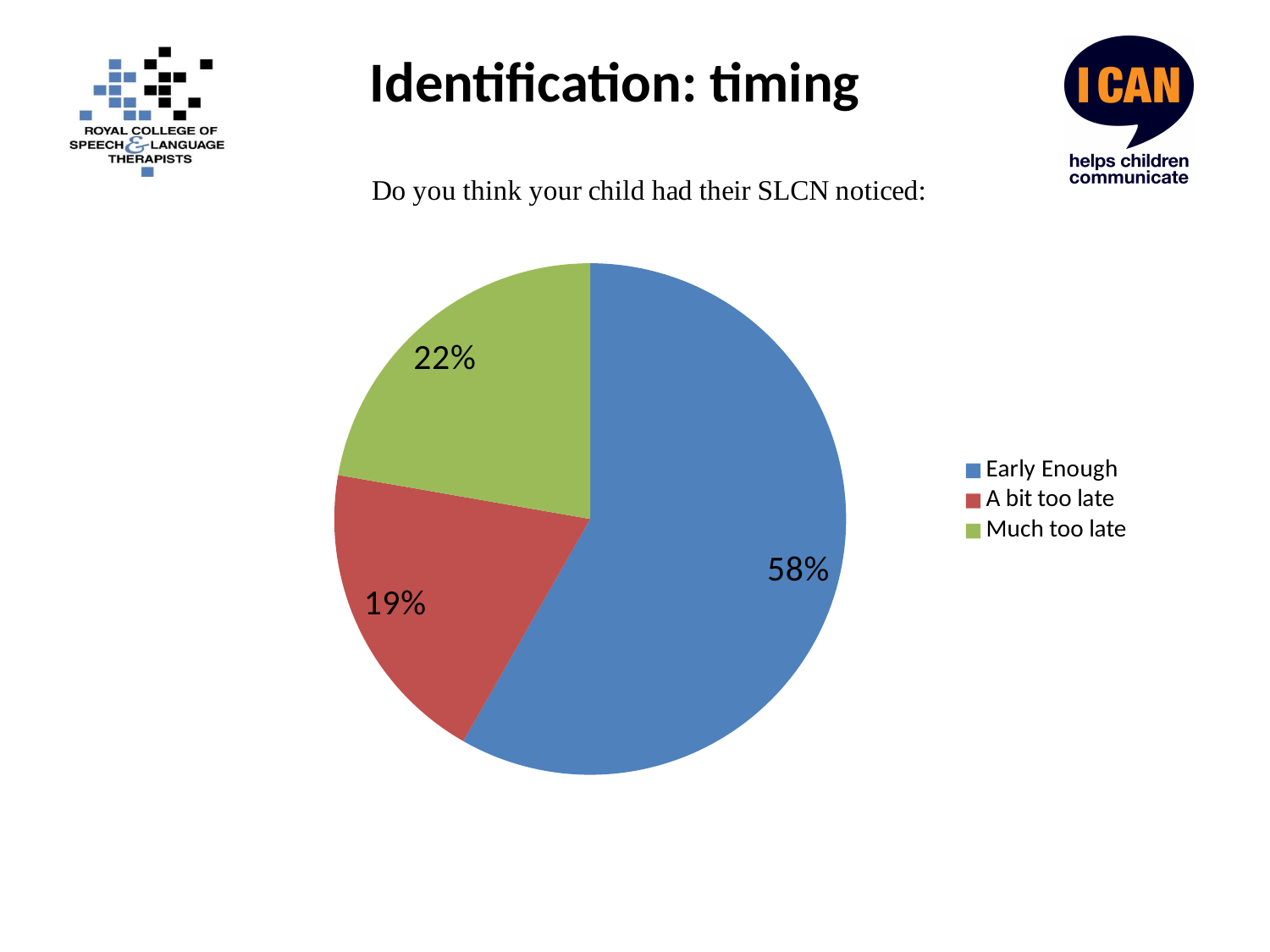
What kind of chart is shown on the slide? pie chart What is the difference in percentage points between the "Much too late" slice and the "A bit too late" slice? 3 How many entries does the legend list? 3 What is the difference in percentage points between the "Early Enough" slice and the "Much too late" slice? 36 Which category has the largest slice of the pie? Early Enough Which is larger, the "Much too late" slice or the "A bit too late" slice? Much too late How many categories does the pie chart show? 3 What share of the pie is labelled "A bit too late"? 19% What colour is the "Early Enough" slice in the pie chart? blue Which category has the smallest slice of the pie? A bit too late What share of the pie is labelled "Much too late"? 22% What share of the pie is labelled "Early Enough"? 58%